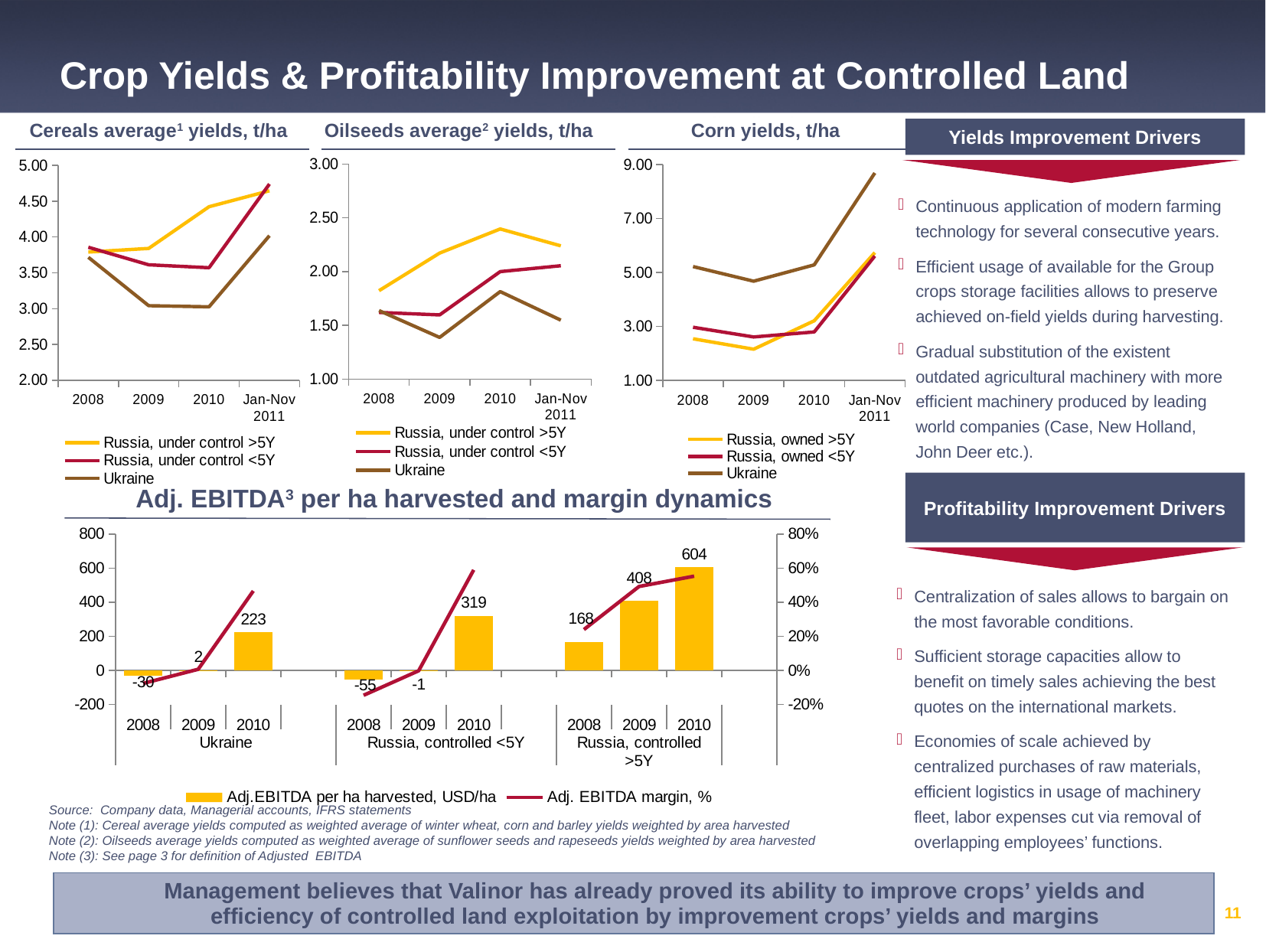
In the 'Cereals average yields, t/ha' chart, is the value for Ukraine in 2009 greater or less than 3.50? less In the 'Adj. EBITDA per ha harvested and margin dynamics' chart, what is the Adj. EBITDA per ha harvested for Ukraine in 2008? -30 In the 'Cereals average yields, t/ha' chart, does the Russia, under control >5Y line rise or fall from 2008 to Jan-Nov 2011? rise In the 'Adj. EBITDA per ha harvested and margin dynamics' chart, by how much did Adj. EBITDA per ha harvested for Russia, controlled >5Y increase from 2009 to 2010? 196 In the 'Adj. EBITDA per ha harvested and margin dynamics' chart, what is the Adj. EBITDA per ha harvested for Russia, controlled >5Y in 2010? 604 In the 'Adj. EBITDA per ha harvested and margin dynamics' chart, which is larger in 2010: Adj. EBITDA per ha harvested for Ukraine or for Russia, controlled <5Y? Russia, controlled <5Y In the 'Adj. EBITDA per ha harvested and margin dynamics' chart, which bar has the lowest Adj. EBITDA per ha harvested? Russia, controlled <5Y, 2008 In the 'Adj. EBITDA per ha harvested and margin dynamics' chart, which bar has the highest Adj. EBITDA per ha harvested? Russia, controlled >5Y, 2010 In the 'Corn yields, t/ha' chart, is the value for Ukraine in Jan-Nov 2011 greater or less than 7.00? greater In the 'Corn yields, t/ha' chart, how many series does the legend list? 3 In the 'Oilseeds average yields, t/ha' chart, how many periods are shown on the x axis? 4 What kind of chart is the 'Cereals average yields, t/ha' chart? line chart